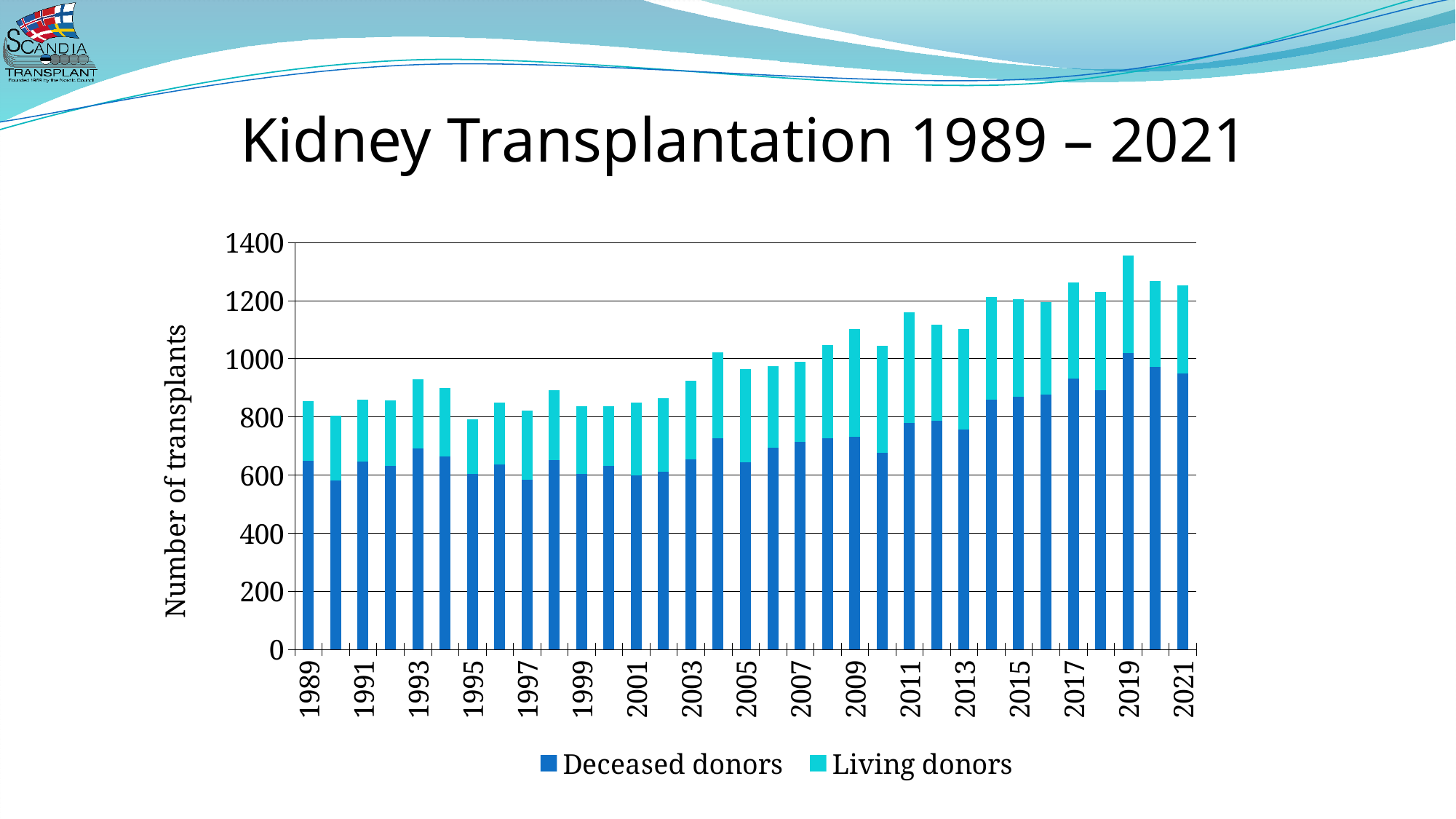
Is the number of deceased donor transplants in 2021 greater or less than 800? greater How many series does the legend list? 2 How many years (bars) are plotted in the chart? 33 Is the total number of transplants in 2019 greater or less than 1200? greater Is the total number of transplants in 1989 greater or less than 1000? less Overall, do total transplants rise or fall from 1989 to 2021? rise What is the label on the vertical axis? Number of transplants Which year has the highest total number of transplants? 2019 What kind of chart is shown on the slide? Stacked bar chart Which year has the larger total number of transplants, 1989 or 2019? 2019 Which series is shown in the lighter cyan colour? Living donors